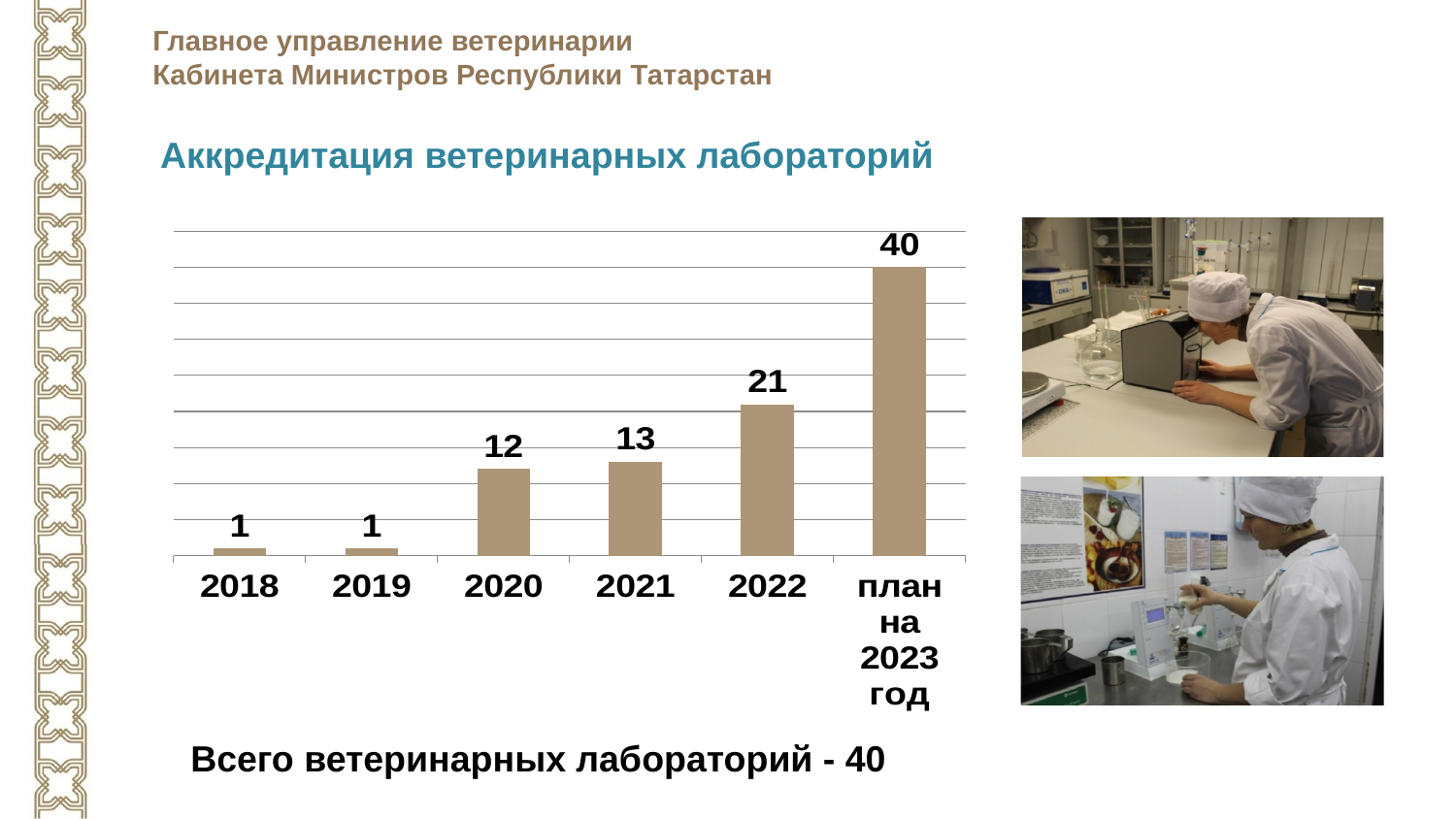
What is the value for 2020? 12 What is the difference between the values for 2022 and 2021? 8 What kind of chart is shown on the slide? bar chart Do the values rise or fall from 2018 to 2022? rise What is the value for 2022? 21 What is the difference between the value for 'план на 2023 год' and the value for 2022? 19 Which is larger, the value for 2021 or the value for 2020? 2021 Which category has the highest value? план на 2023 год What is the title of the chart? Аккредитация ветеринарных лабораторий How many categories are shown on the x axis? 6 What is the value for 'план на 2023 год'? 40 What is the value for 2018? 1